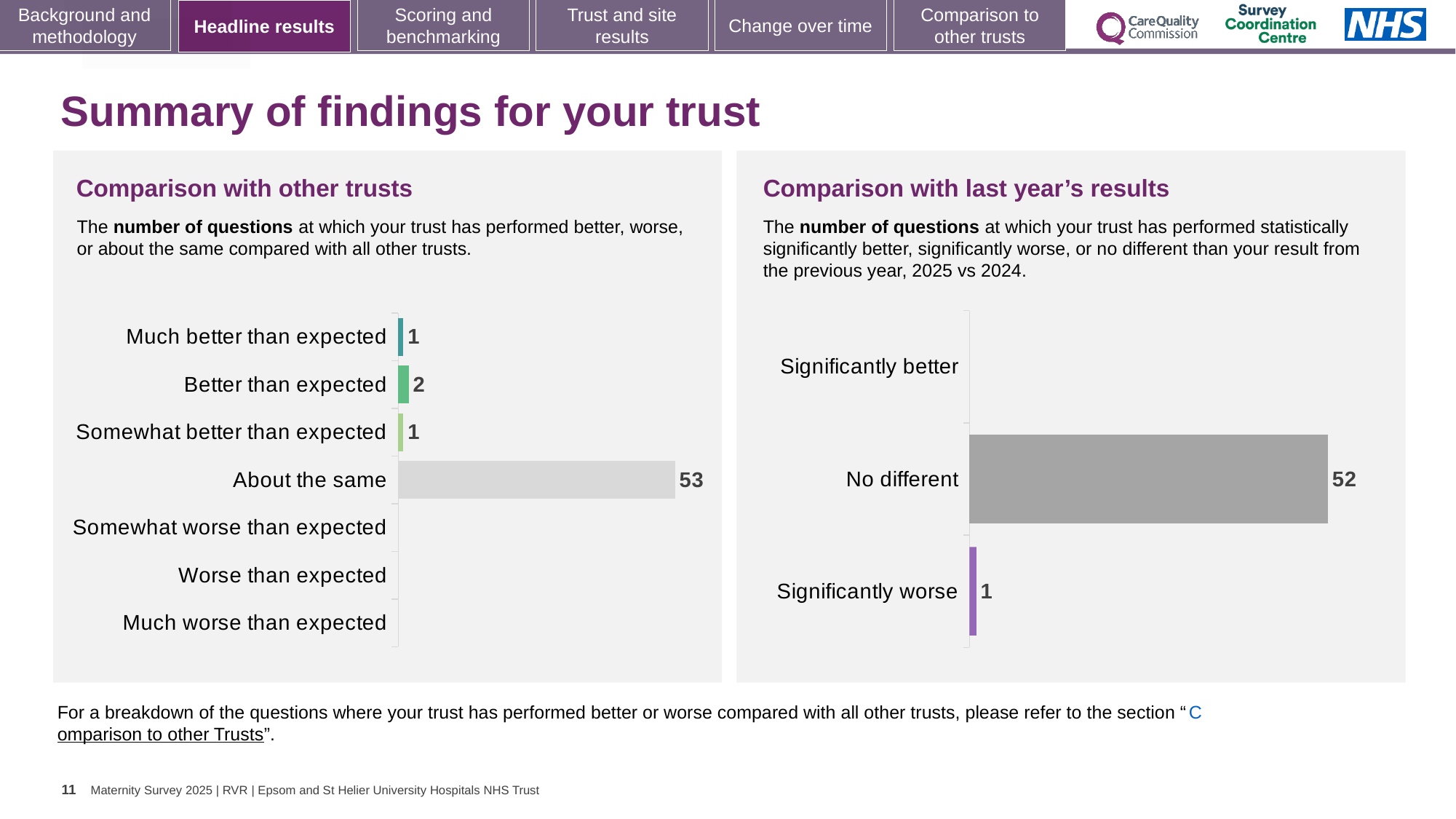
In the 'Comparison with other trusts' chart, how many categories are listed on the axis? 7 What type of chart is the 'Comparison with last year's results' chart? Bar chart In the 'Comparison with last year's results' chart, which category has the highest value? No different In the 'Comparison with last year's results' chart, how many questions are 'Significantly worse'? 1 In the 'Comparison with last year's results' chart, how many questions are 'No different'? 52 What is the title of the chart on the left side of the slide? Comparison with other trusts In the 'Comparison with last year's results' chart, what is the difference between 'No different' and 'Significantly worse'? 51 In the 'Comparison with other trusts' chart, which category has the highest value? About the same In the 'Comparison with other trusts' chart, how many questions are 'Better than expected'? 2 In the 'Comparison with other trusts' chart, which is larger: 'Better than expected' or 'Much better than expected'? Better than expected In the 'Comparison with other trusts' chart, what is the difference between 'About the same' and 'Better than expected'? 51 In the 'Comparison with other trusts' chart, how many questions are 'About the same'? 53